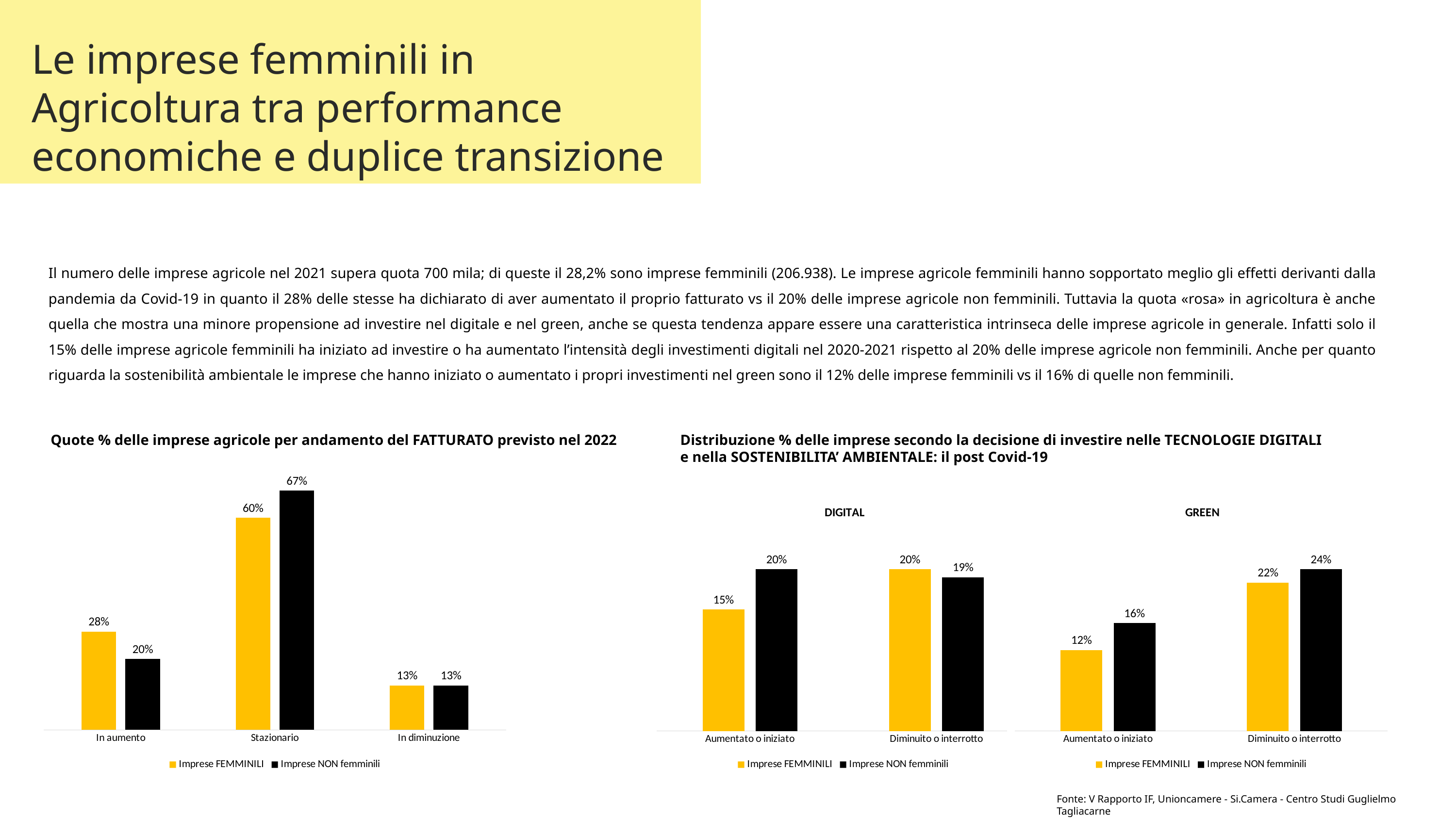
In the 'DIGITAL' chart, which is larger in the 'Diminuito o interrotto' category: Imprese FEMMINILI or Imprese NON femminili? Imprese FEMMINILI In the chart 'Quote % delle imprese agricole per andamento del FATTURATO previsto nel 2022', what colour are the bars for Imprese FEMMINILI? Yellow In the 'GREEN' chart, what is the value for Imprese NON femminili in the 'Diminuito o interrotto' category? 24% What kind of chart is the 'DIGITAL' chart on the right side of the slide? Bar chart In the chart 'Quote % delle imprese agricole per andamento del FATTURATO previsto nel 2022', how many categories are shown on the x axis? 3 In the chart 'Quote % delle imprese agricole per andamento del FATTURATO previsto nel 2022', how many series does the legend list? 2 In the chart 'Quote % delle imprese agricole per andamento del FATTURATO previsto nel 2022', what is the value for Imprese FEMMINILI in the 'In aumento' category? 28% In the chart 'Quote % delle imprese agricole per andamento del FATTURATO previsto nel 2022', which category has the highest value for Imprese FEMMINILI? Stazionario In the chart 'Quote % delle imprese agricole per andamento del FATTURATO previsto nel 2022', what is the difference between Imprese NON femminili and Imprese FEMMINILI in the 'Stazionario' category? 7% In the 'GREEN' chart, what is the difference between Imprese NON femminili and Imprese FEMMINILI in the 'Aumentato o iniziato' category? 4% In the chart 'Quote % delle imprese agricole per andamento del FATTURATO previsto nel 2022', what is the value for Imprese NON femminili in the 'Stazionario' category? 67% In the 'DIGITAL' chart, what is the value for Imprese FEMMINILI in the 'Aumentato o iniziato' category? 15%